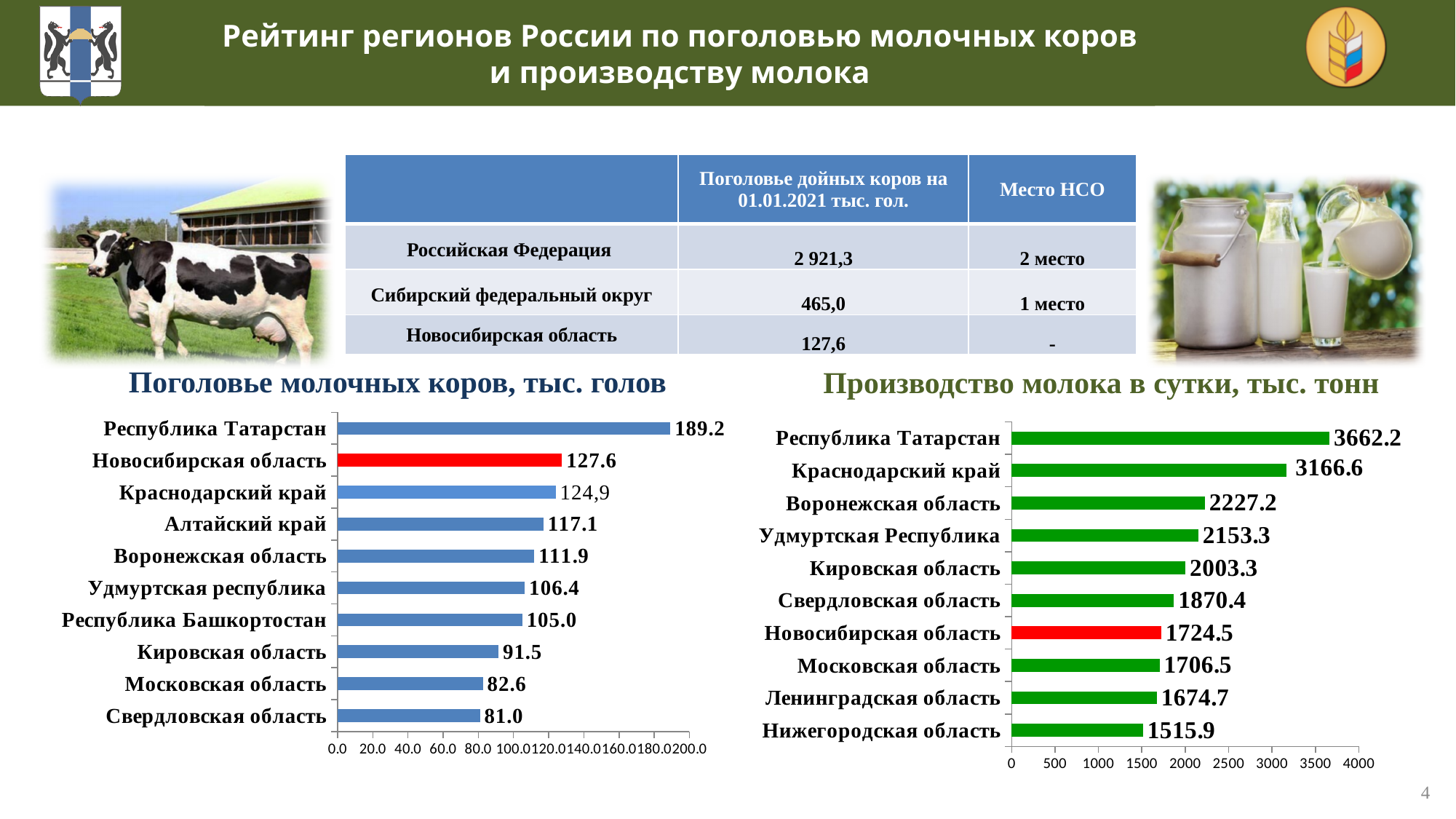
On the chart 'Производство молока в сутки, тыс. тонн', which bar is coloured red? Новосибирская область On the chart 'Производство молока в сутки, тыс. тонн', is the value for Воронежская область greater or less than 2000? greater On the chart 'Производство молока в сутки, тыс. тонн', which is larger: Новосибирская область or Московская область? Новосибирская область On the chart 'Поголовье молочных коров, тыс. голов', which region has the highest value? Республика Татарстан On the chart 'Производство молока в сутки, тыс. тонн', which region has the lowest value? Нижегородская область On the chart 'Поголовье молочных коров, тыс. голов', what is the difference between Республика Татарстан and Новосибирская область? 61.6 On the chart 'Производство молока в сутки, тыс. тонн', what is the difference between Республика Татарстан and Краснодарский край? 495.6 On the chart 'Поголовье молочных коров, тыс. голов', how many regions are shown? 10 On the chart 'Поголовье молочных коров, тыс. голов', which region has the lowest value? Свердловская область What type of chart is 'Поголовье молочных коров, тыс. голов'? Bar chart On the chart 'Поголовье молочных коров, тыс. голов', what is the value for Новосибирская область? 127.6 On the chart 'Производство молока в сутки, тыс. тонн', what is the value for Кировская область? 2003.3